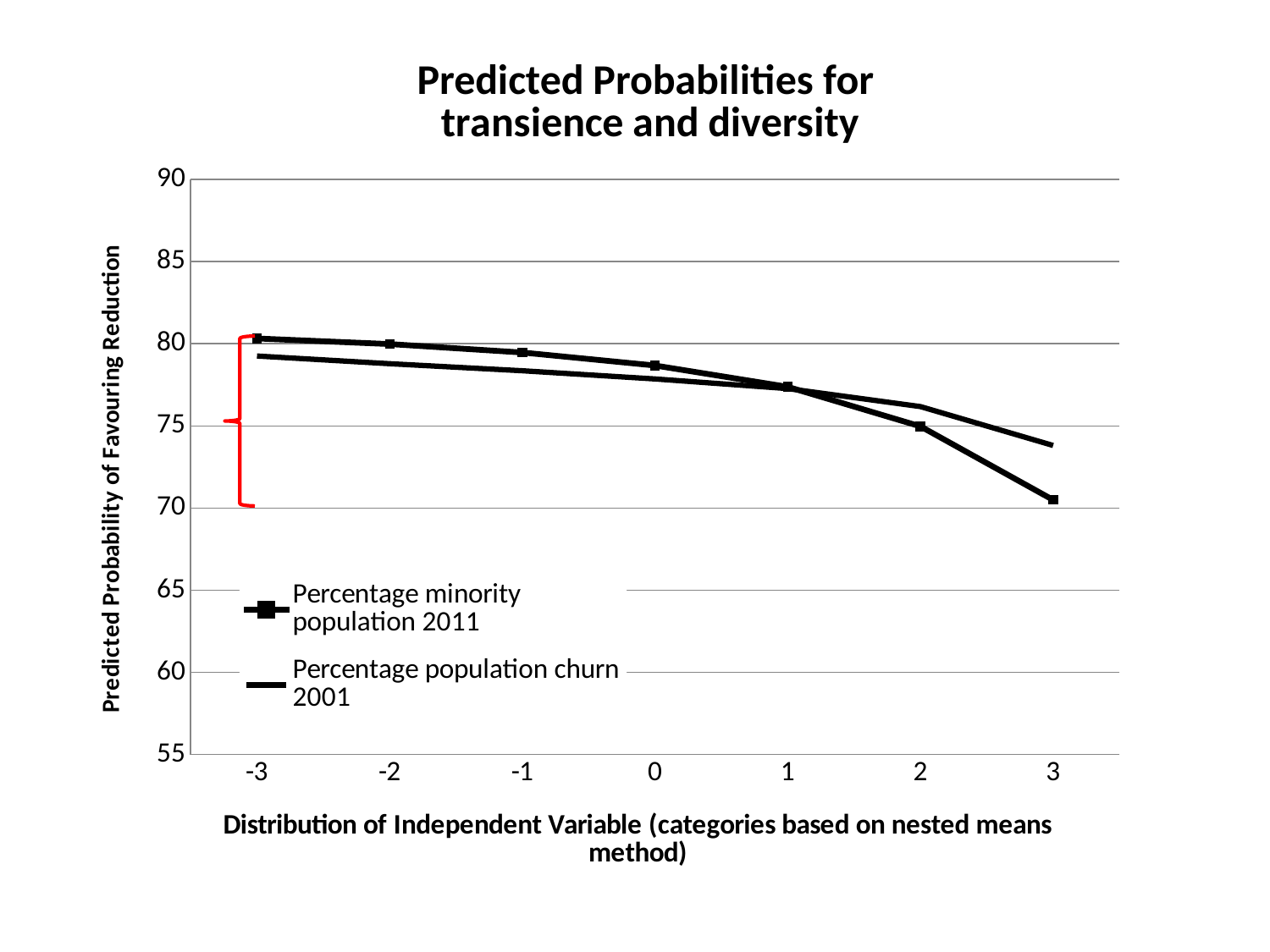
Is the value for Percentage population churn 2001 at x = 3 greater or less than 75? less Do the values for Percentage population churn 2001 rise or fall as the x axis goes from -3 to 3? fall How many series does the legend list? 2 At x = -3, which series has the higher value: Percentage minority population 2011 or Percentage population churn 2001? Percentage minority population 2011 What is the title of the chart? Predicted Probabilities for transience and diversity What kind of chart is shown on the slide? line chart At which x-axis category is the value for Percentage minority population 2011 lowest? 3 Do the values for Percentage minority population 2011 rise or fall as the x axis goes from -3 to 3? fall At x = 3, which series has the higher value: Percentage minority population 2011 or Percentage population churn 2001? Percentage population churn 2001 At which x-axis category is the value for Percentage minority population 2011 highest? -3 How many categories are shown on the x axis? 7 Is the value for Percentage minority population 2011 at x = 3 greater or less than 75? less